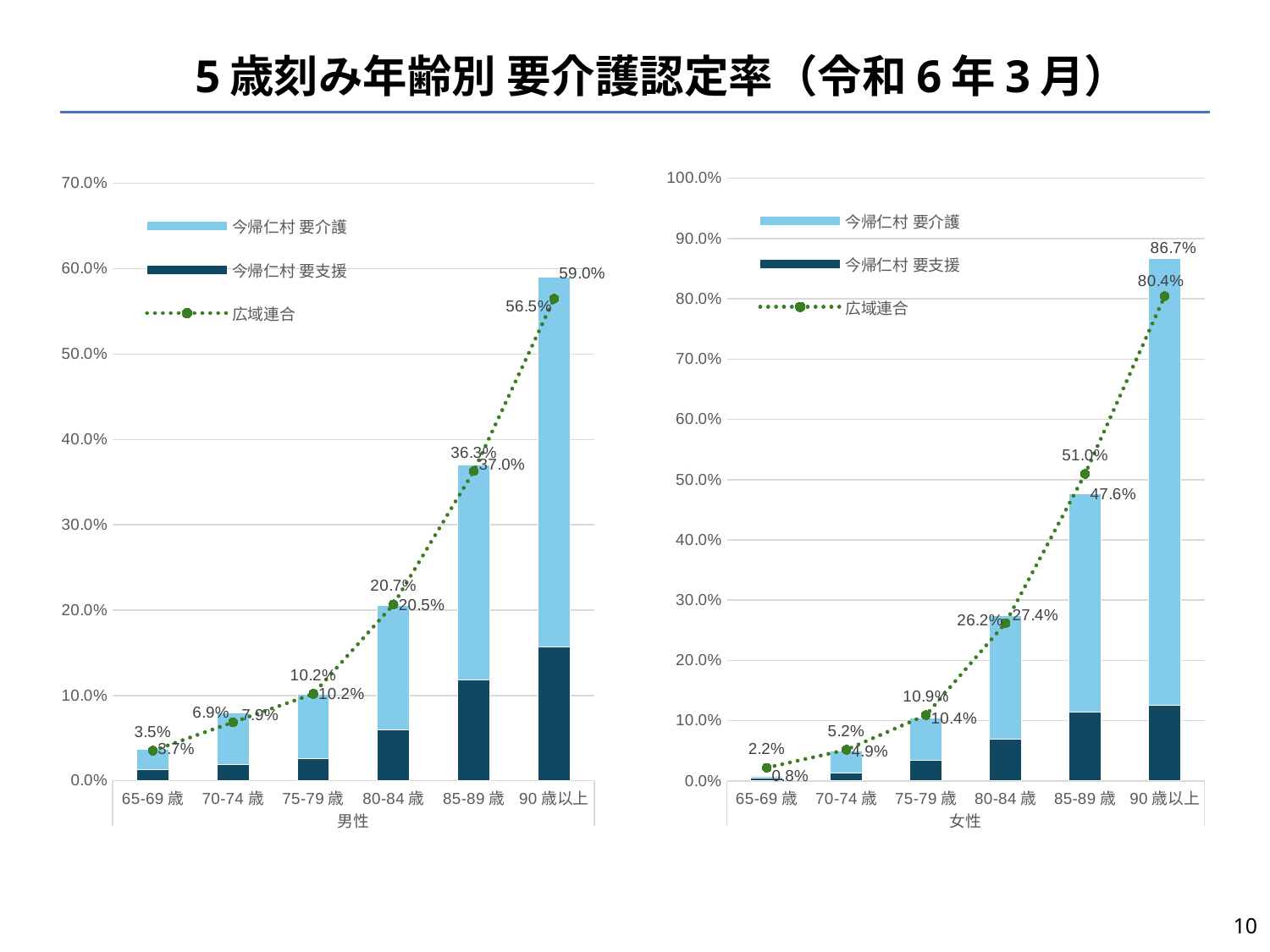
How many age groups are shown on the x axis of the left chart (男性)? 6 In the left chart (男性), what is the 広域連合 value for 90歳以上? 56.5% In the left chart (男性), is the 今帰仁村 要支援 segment for 90歳以上 greater or less than 20.0%? less In the left chart (男性), which age group has the lowest 広域連合 value? 65-69歳 What kind of chart is the left chart (男性)? bar chart with a dotted line In the right chart (女性), for 85-89歳, which is larger: the 広域連合 value or the labelled bar value? 広域連合 In the right chart (女性), do the 広域連合 values rise or fall as age increases along the x axis? rise In the right chart (女性), what is the labelled value of the bar for 65-69歳? 0.8% How many series does the legend of the right chart (女性) list? 3 In the left chart (男性), what is the difference between the bar label for 90歳以上 (59.0%) and the 広域連合 value for 90歳以上 (56.5%)? 2.5% In the right chart (女性), which age group has the tallest bar? 90歳以上 In the right chart (女性), what is the 広域連合 value for 85-89歳? 51.0%